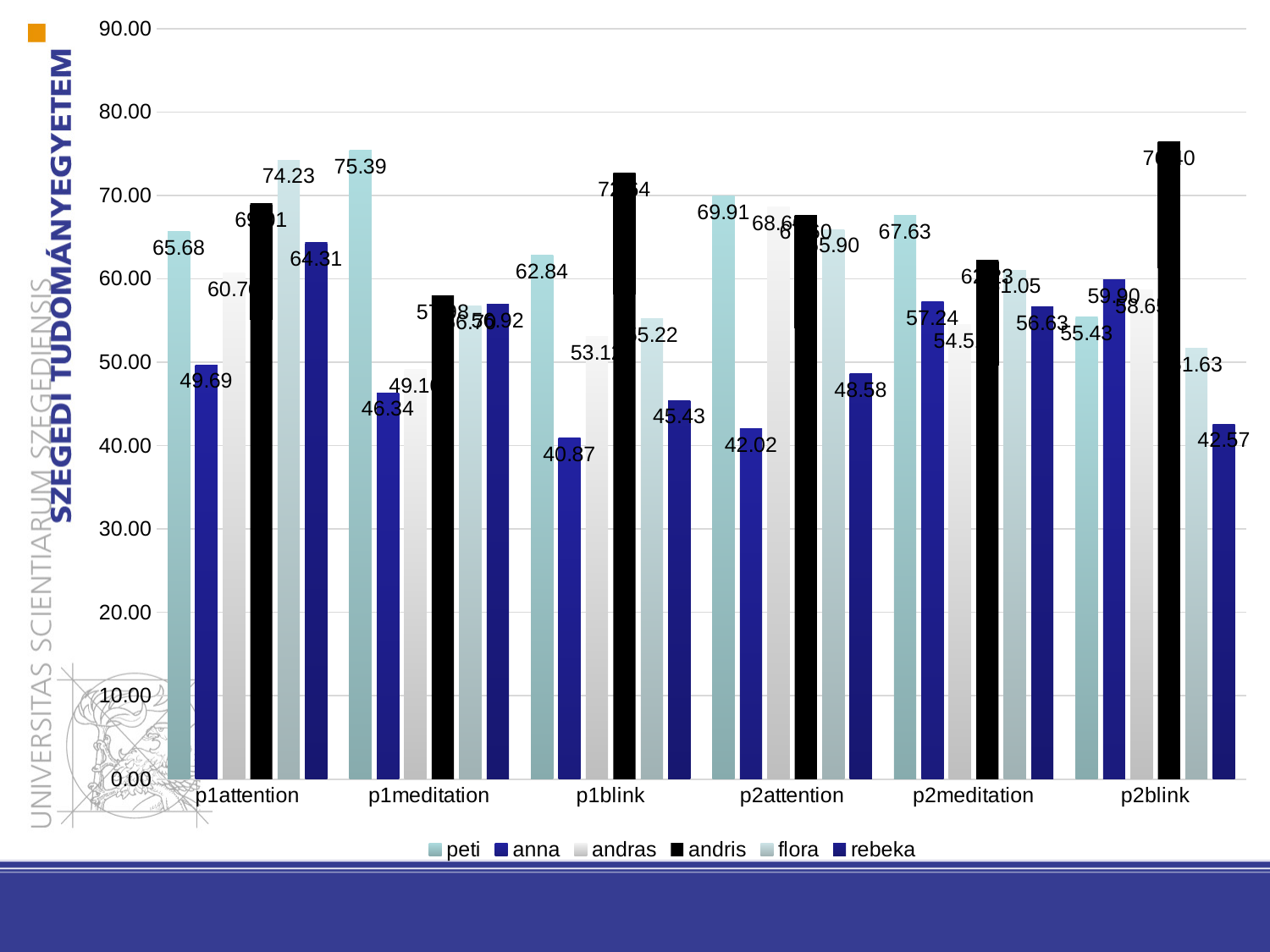
How many series does the legend list? 6 What is the value for rebeka in the p2blink category? 42.57 What kind of chart is shown on the slide? bar chart How many categories are shown on the x axis? 6 In which category does peti have the highest value? p1meditation What is the difference between peti's and anna's values in the p1attention category? 15.99 What is the value for anna in the p1blink category? 40.87 What is the value for peti in the p1meditation category? 75.39 In which category does anna have the lowest value? p1blink What is the value for flora in the p1attention category? 74.23 Is the value for andris in the p2blink category greater or less than 70.00? greater In the p2blink category, which is larger: the value for anna or the value for peti? anna